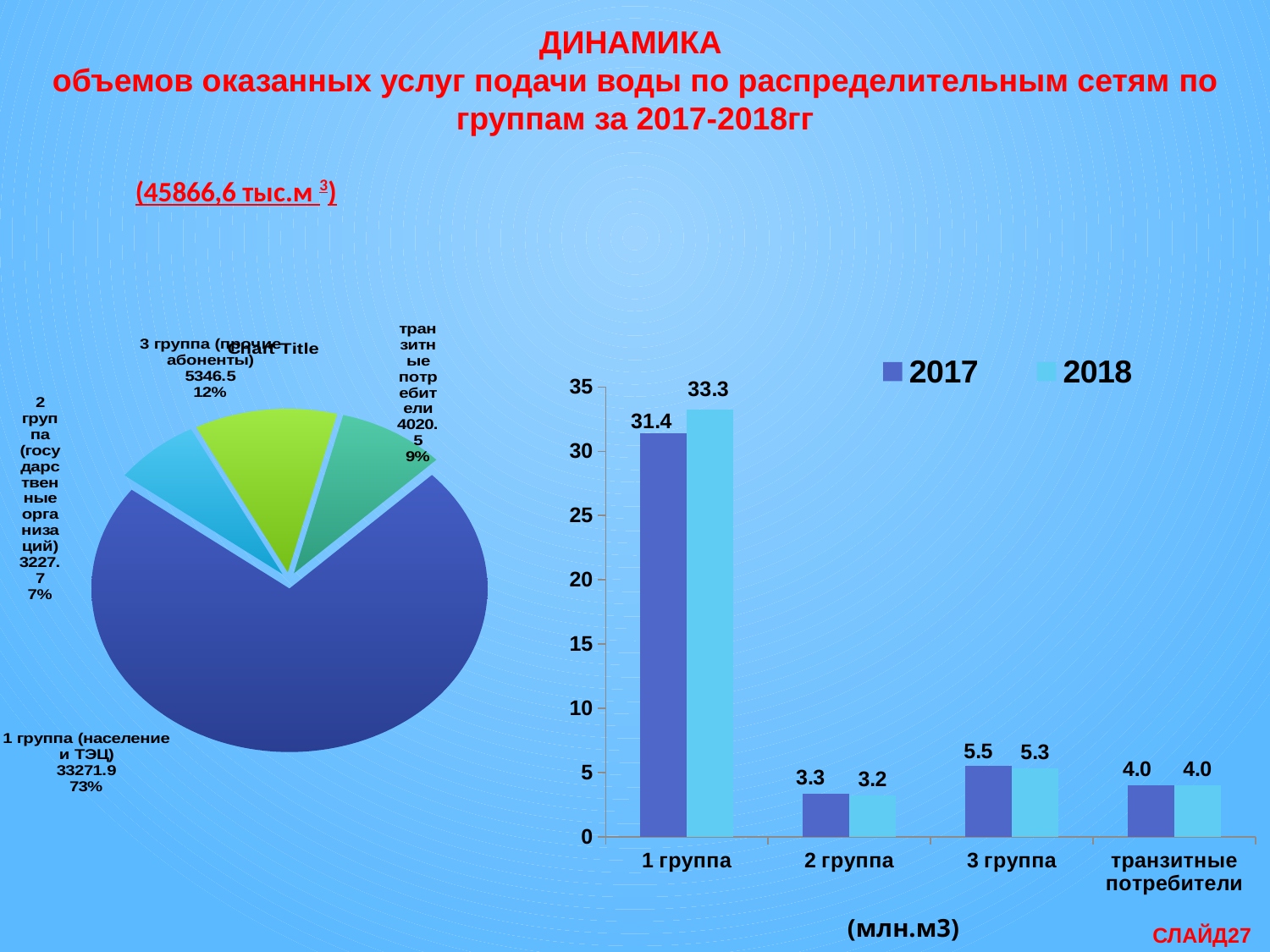
In the pie chart on the left, what is the value for 3 группа (прочие абоненты)? 5346.5 In the bar chart on the right, what is the difference between the 2018 and 2017 values for 1 группа? 1.9 In the pie chart on the left, what share does 1 группа (население и ТЭЦ) have? 73% In the bar chart on the right, what is the 2018 value for 3 группа? 5.3 What kind of chart is on the left side of the slide? Pie chart In the bar chart on the right, which category has the highest 2018 value? 1 группа In the bar chart on the right, how many series does the legend list? 2 In the bar chart on the right, which category has the lowest 2017 value? 2 группа In the bar chart on the right, what is the 2018 value for транзитные потребители? 4.0 In the bar chart on the right, how many categories are shown on the x axis? 4 In the bar chart on the right, which is larger for 3 группа: the 2017 value or the 2018 value? 2017 In the bar chart on the right, what is the 2017 value for 1 группа? 31.4